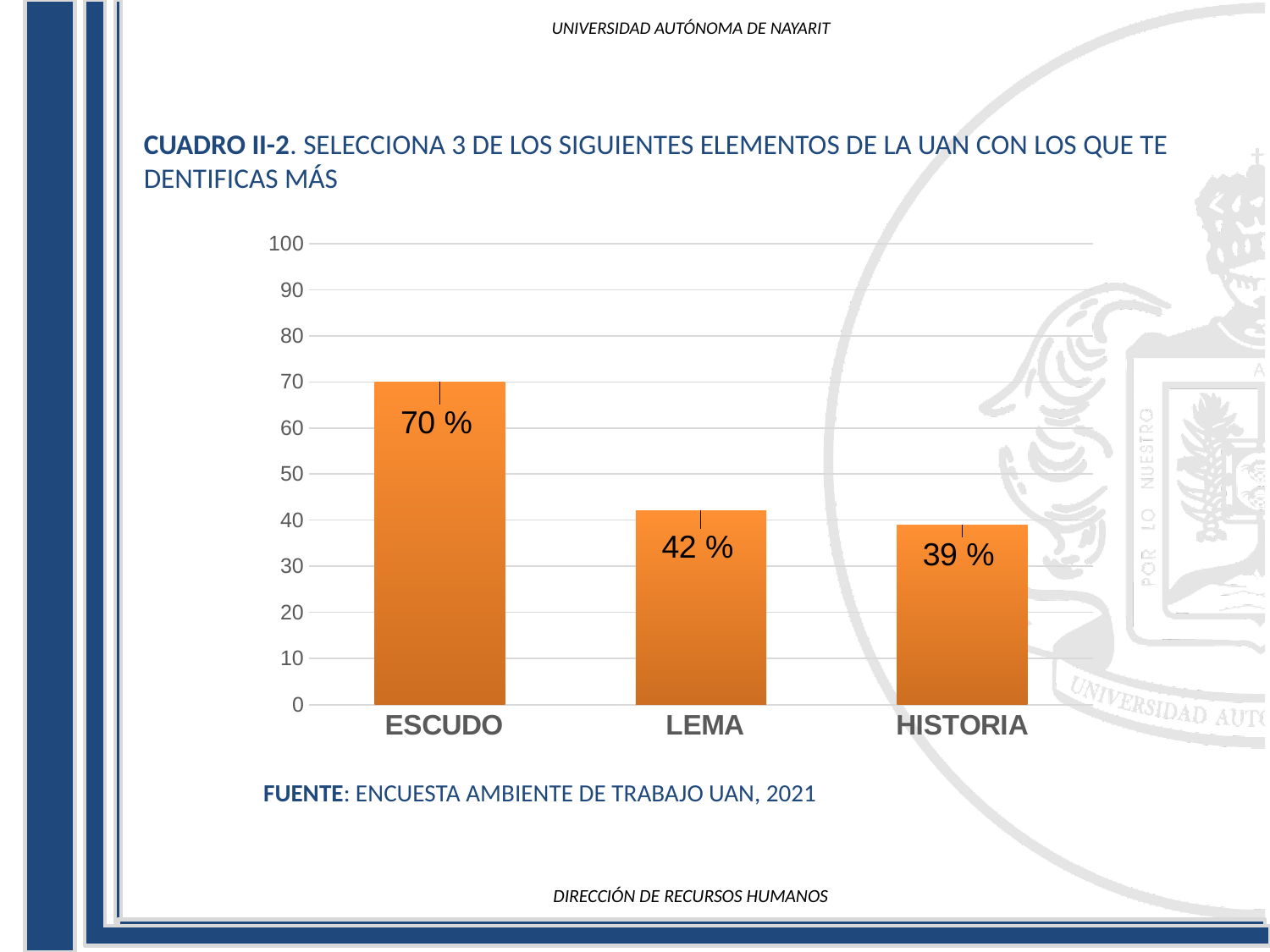
Which category has the lowest value? HISTORIA Which category has the highest value? ESCUDO What is the value for ESCUDO? 70 % What is the value for HISTORIA? 39 % How many categories are shown on the chart? 3 Which is larger, the value for ESCUDO or the value for HISTORIA? ESCUDO What kind of chart is shown on the slide? bar chart Do the values rise or fall from left to right across the categories? fall What is the difference between the values for ESCUDO and LEMA? 28 % What is the value for LEMA? 42 % Is the value for ESCUDO greater or less than 60? greater What is the difference between the values for LEMA and HISTORIA? 3 %